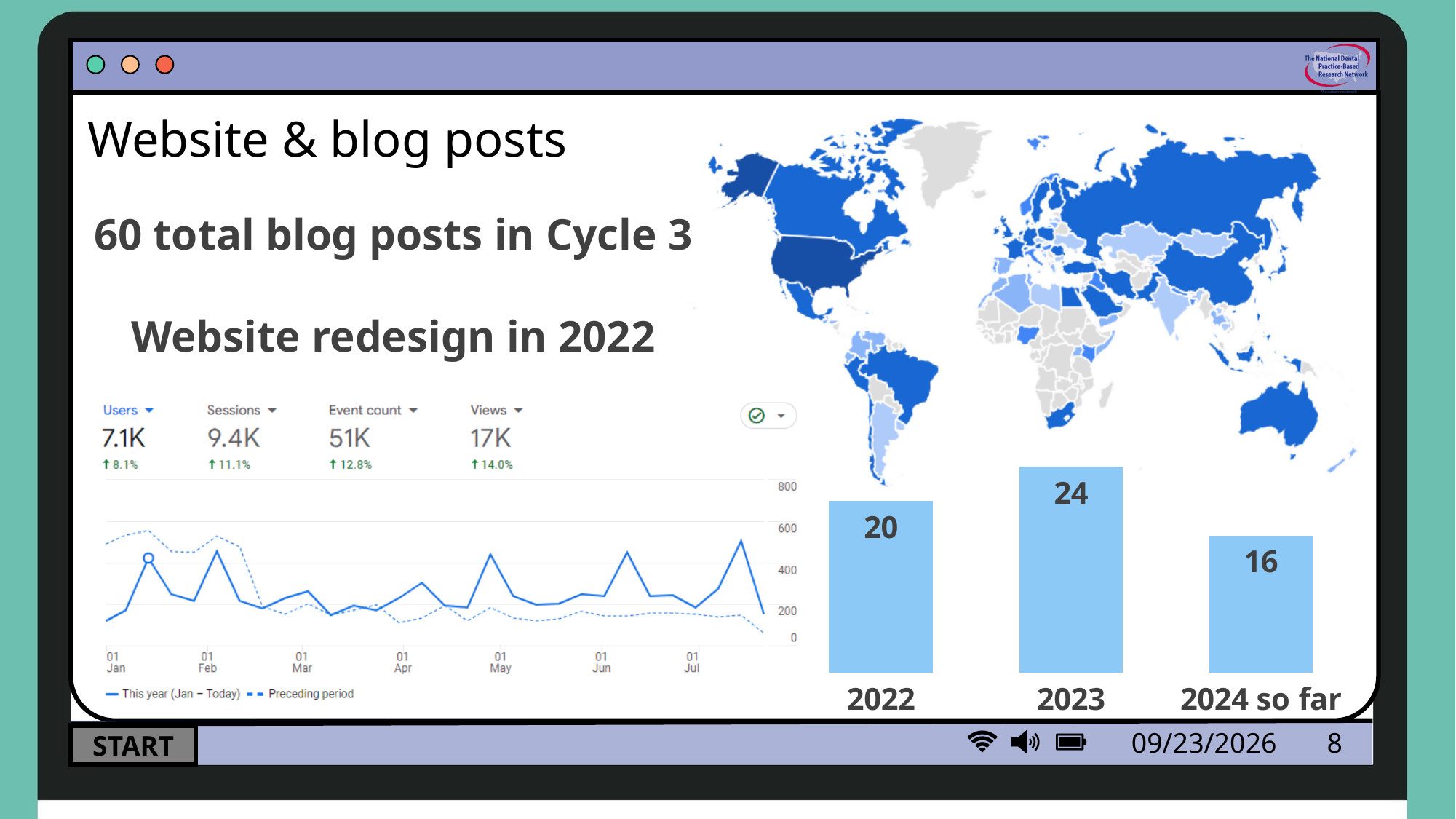
In the bar chart on the right, what is the total of the three bars? 60 In the bar chart on the right, what is the difference between the 2023 and 2022 values? 4 What kind of chart is shown at the bottom right of the slide? Bar chart In the line chart at the bottom left, is the highest peak of the solid 'This year' line greater or less than 400? greater In the bar chart on the right, which year has the highest number of blog posts? 2023 How many bars are in the bar chart on the right? 3 In the line chart at the bottom left, what are the two legend entries? This year (Jan – Today) and Preceding period In the bar chart on the right, which is larger, the value for 2022 or the value for 2024 so far? 2022 In the bar chart on the right, what is the value for 2024 so far? 16 In the bar chart on the right, how many blog posts were there in 2023? 24 How many series does the legend of the line chart at the bottom left list? 2 In the bar chart on the right, which category has the lowest value? 2024 so far